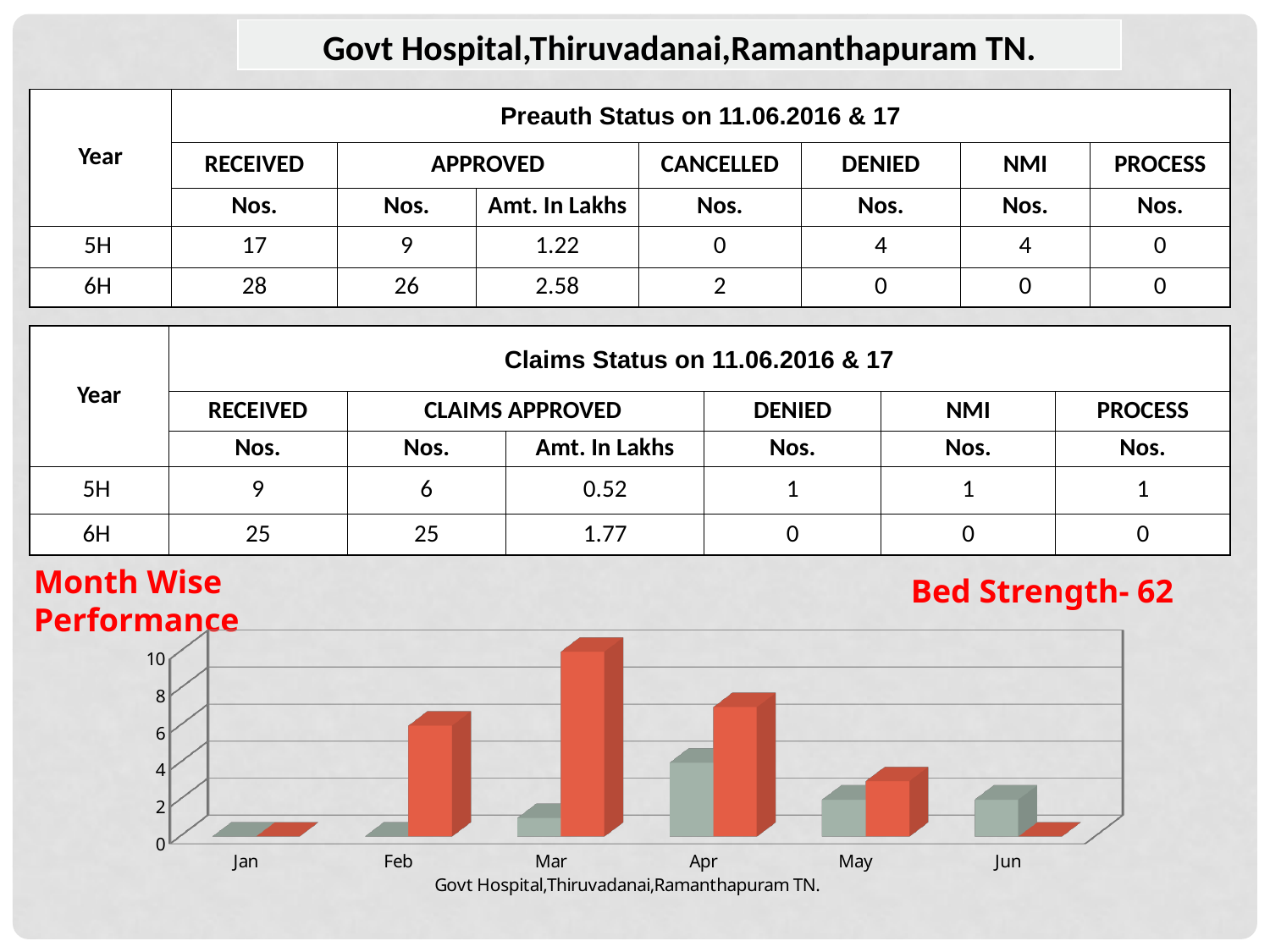
How many series of bars (distinct colours) are plotted in the Month Wise Performance chart? 2 In the Month Wise Performance chart, is the red bar for Feb greater or less than 4? greater In the Month Wise Performance chart, is the red bar for May greater or less than 6? less In the Month Wise Performance chart, which month has the tallest red bar? Mar In the Month Wise Performance chart, is the red bar for Mar greater or less than 8? greater In the Month Wise Performance chart, which is larger: the grey bar for Apr or the grey bar for May? Apr What text appears as the title beneath the Month Wise Performance chart? Govt Hospital,Thiruvadanai,Ramanthapuram TN. In the Month Wise Performance chart, which is larger: the red bar for Mar or the red bar for Apr? Mar What kind of chart is shown under 'Month Wise Performance'? bar chart How many months are shown on the x axis of the Month Wise Performance chart? 6 In the Month Wise Performance chart, which month has the tallest grey bar? Apr